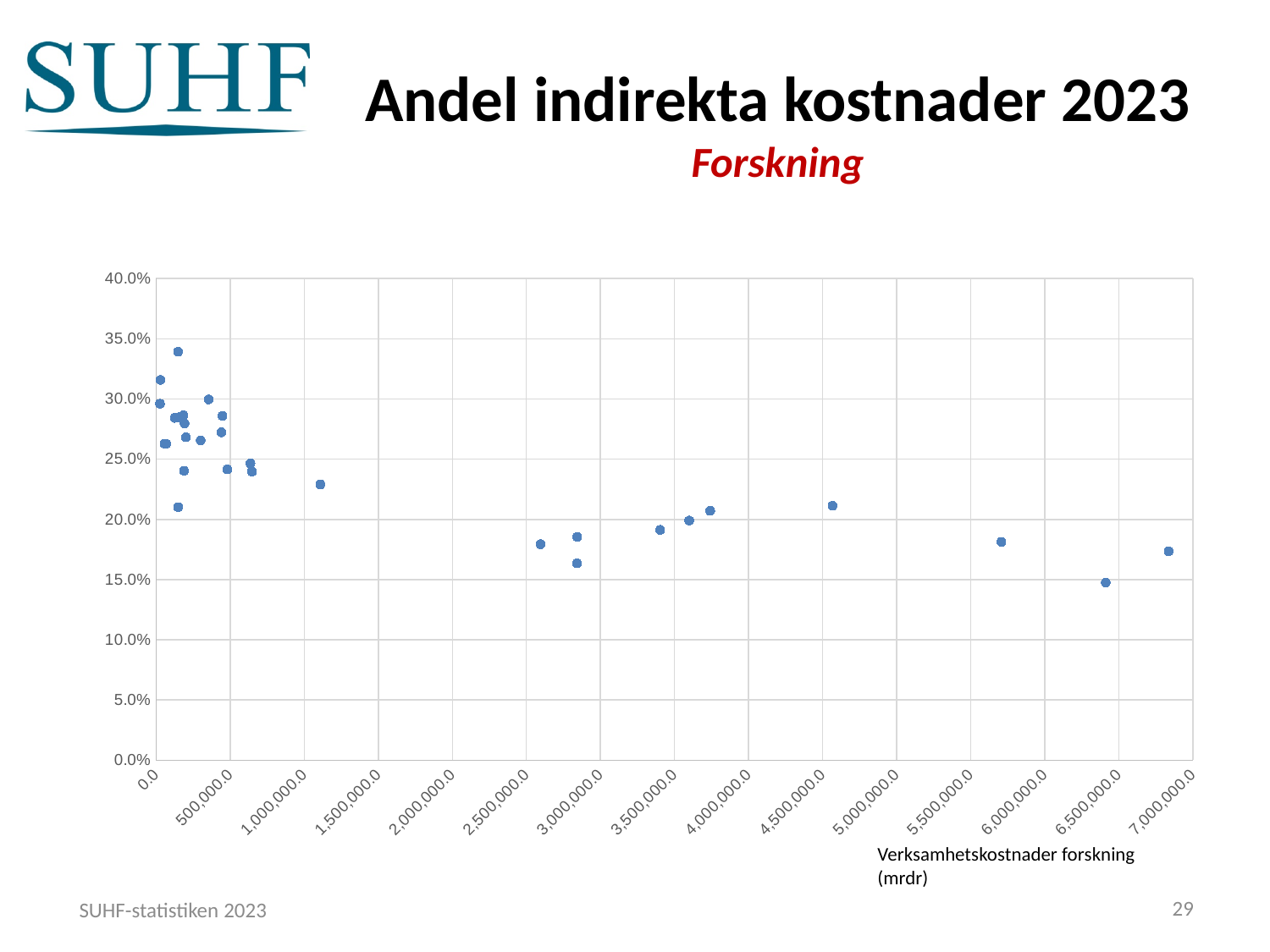
Is the value of the lowest point on the chart (near 6,500,000.0 on the x axis) greater or less than 10.0%? greater What is the maximum value shown on the y axis? 40.0% In which part of the x axis does the highest point on the chart lie: below 500,000.0 or above 500,000.0? below 500,000.0 What kind of chart is shown on the slide? scatter chart Is the value of the point near 4,500,000.0 on the x axis greater or less than 20.0%? greater Is the value of the point near 1,100,000.0 on the x axis greater or less than 20.0%? greater As Verksamhetskostnader forskning increases along the x axis, do the share values generally rise or fall? fall What is the label of the x axis? Verksamhetskostnader forskning (mrdr) Which point is higher: the point near 4,500,000.0 on the x axis or the point near 6,500,000.0 on the x axis? the point near 4,500,000.0